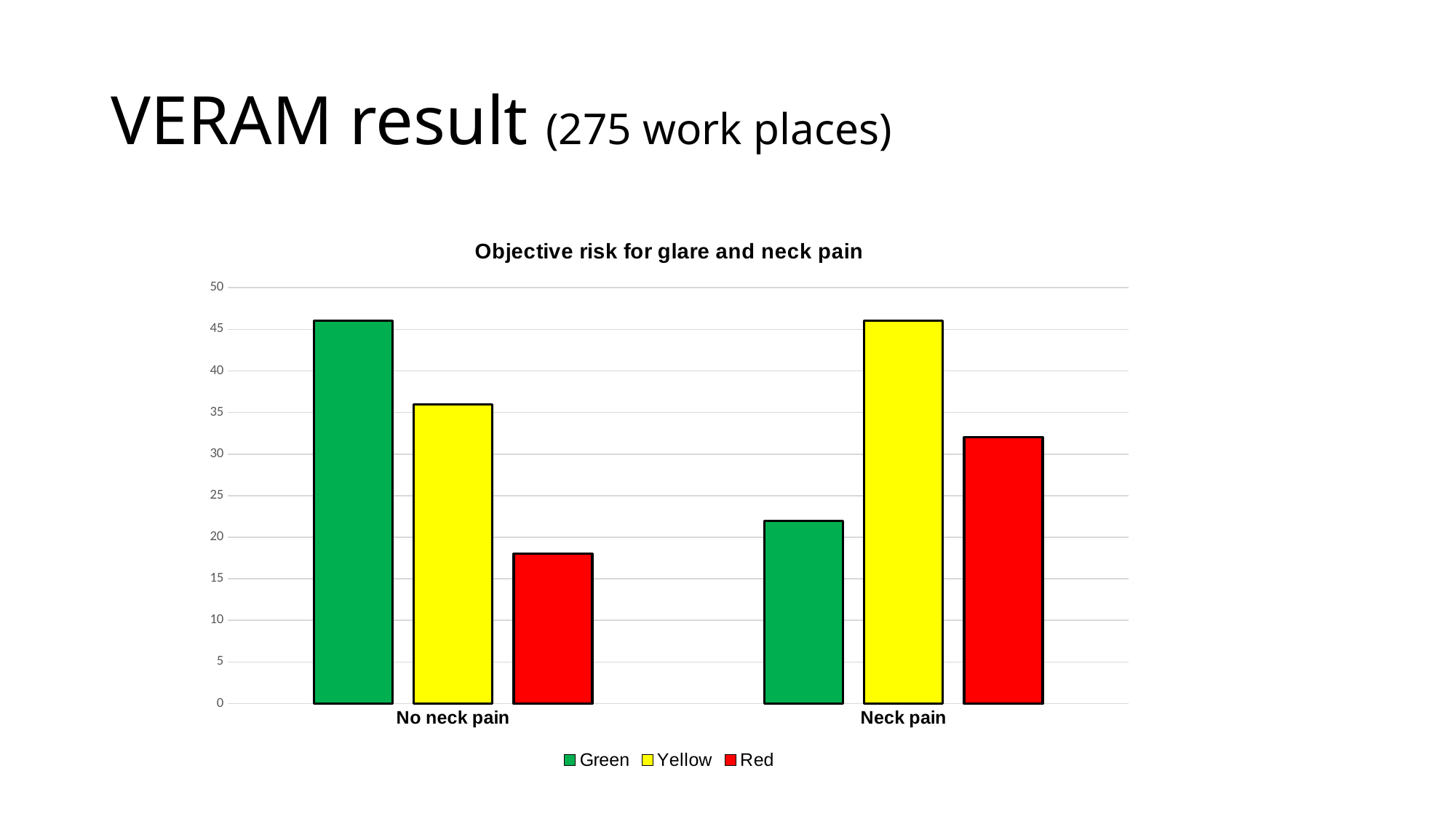
Is the value for Red in the Neck pain category greater or less than 30? greater Which series has the lowest value in the Neck pain category? Green Which series has the lowest value in the No neck pain category? Red How many series does the legend list? 3 Which series has the highest value in the Neck pain category? Yellow Is the value for Green in the No neck pain category greater or less than 40? greater Which series has the highest value in the No neck pain category? Green What kind of chart is shown on the slide? bar chart How many categories are shown on the x axis? 2 Which is larger: the Green value for No neck pain or the Green value for Neck pain? No neck pain Is the value for Red in the No neck pain category greater or less than 20? less What is the title of the chart? Objective risk for glare and neck pain